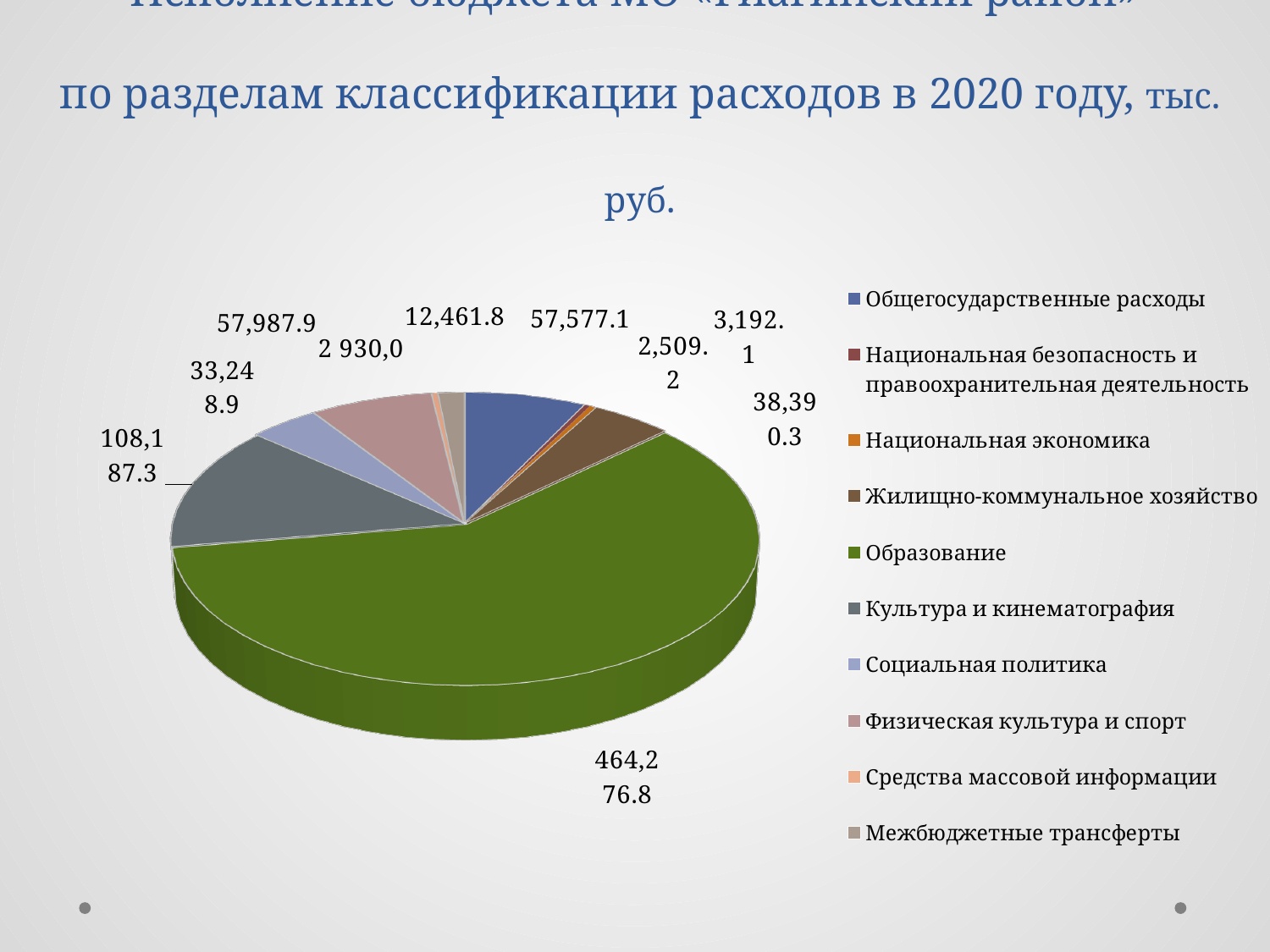
What is the difference between the values for Физическая культура и спорт and Общегосударственные расходы? 410.8 What kind of chart is shown on the slide? pie chart What is the value for Жилищно-коммунальное хозяйство? 38,390.3 Which category has the smallest value in the pie chart? Национальная безопасность и правоохранительная деятельность How many categories does the legend of the pie chart list? 10 What colour is the slice for Образование? green Which is larger: the value for Культура и кинематография or the value for Социальная политика? Культура и кинематография What is the value for Образование? 464,276.8 What is the value for Культура и кинематография? 108,187.3 Which category has the largest slice of the pie? Образование What is the value for Межбюджетные трансферты? 12,461.8 What is the value for Общегосударственные расходы? 57,577.1